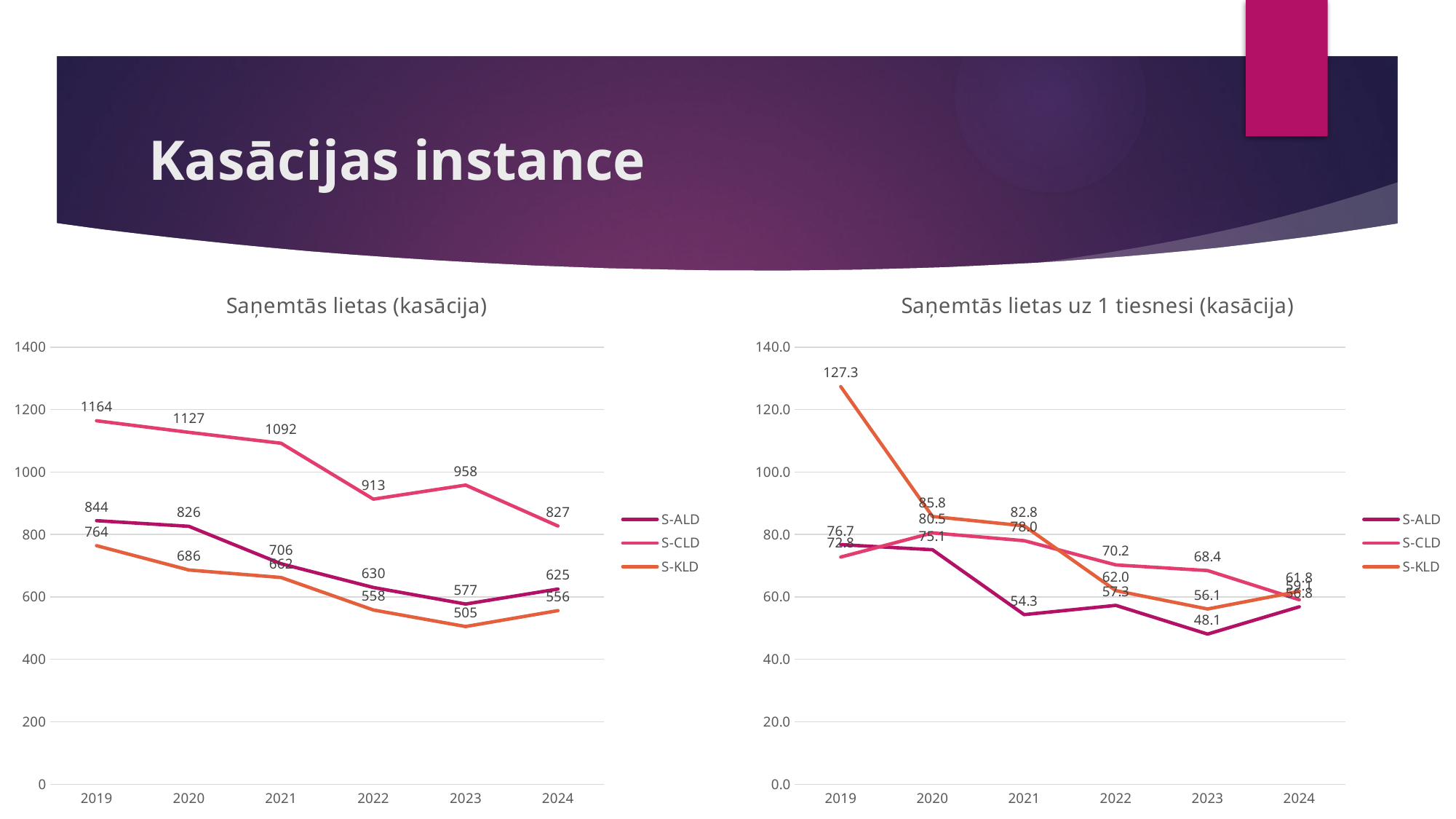
In the chart titled 'Saņemtās lietas (kasācija)', what is the value for S-KLD in 2023? 505 In the chart titled 'Saņemtās lietas uz 1 tiesnesi (kasācija)', what is the value for S-ALD in 2023? 48.1 In the chart titled 'Saņemtās lietas (kasācija)', which series has the larger value in 2022: S-ALD or S-KLD? S-ALD In the chart titled 'Saņemtās lietas uz 1 tiesnesi (kasācija)', what is the value for S-KLD in 2019? 127.3 In the chart titled 'Saņemtās lietas (kasācija)', what is the difference between the S-CLD values in 2019 and 2024? 337 In the chart titled 'Saņemtās lietas (kasācija)', which year has the lowest value for S-ALD? 2023 In the chart titled 'Saņemtās lietas (kasācija)', which year has the highest value for S-CLD? 2019 In the chart titled 'Saņemtās lietas uz 1 tiesnesi (kasācija)', what is the difference between the S-CLD values in 2020 and 2023? 12.1 In the chart titled 'Saņemtās lietas (kasācija)', how many series does the legend list? 3 In the chart titled 'Saņemtās lietas uz 1 tiesnesi (kasācija)', which series has the highest value in 2020? S-KLD In the chart titled 'Saņemtās lietas (kasācija)', what is the value for S-CLD in 2019? 1164 What kind of chart is 'Saņemtās lietas uz 1 tiesnesi (kasācija)'? Line chart